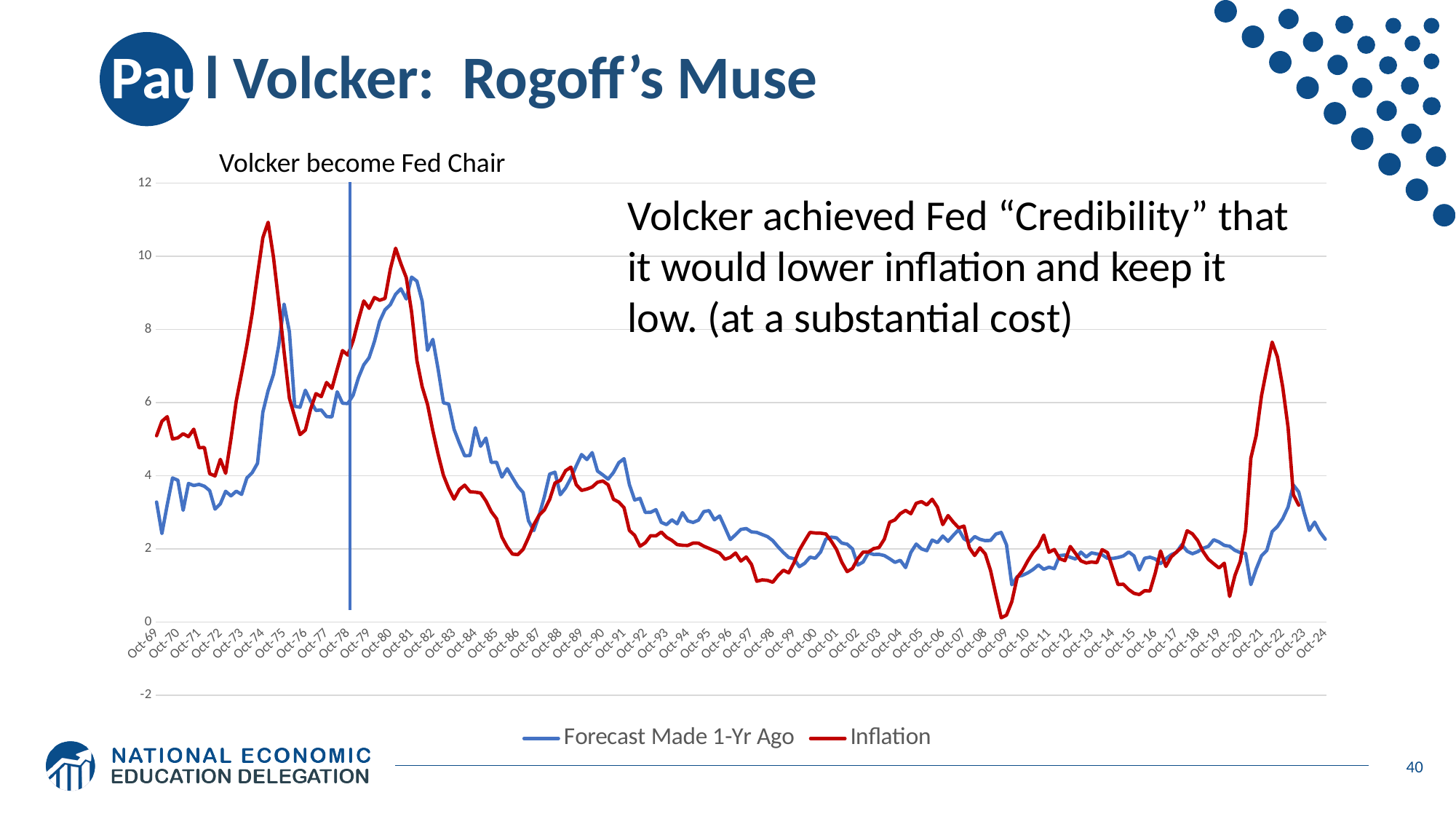
What event does the vertical line on the chart mark, according to the annotation? Volcker become Fed Chair What are the two series named in the chart legend? Forecast Made 1-Yr Ago and Inflation Which series reaches the highest value anywhere on the chart? Inflation Does the Inflation line rise or fall between Oct-80 and Oct-86? fall Is the Inflation value at its peak around Oct-74 greater or less than 10? greater What kind of chart is shown on the slide? line chart Around Oct-74, which series is higher: Inflation or Forecast Made 1-Yr Ago? Inflation Is the Forecast Made 1-Yr Ago value at Oct-69 greater or less than 4? less Is the Inflation value at Oct-09 greater or less than 2? less What is the highest value shown on the chart's vertical axis? 12 How many series does the chart legend list? 2